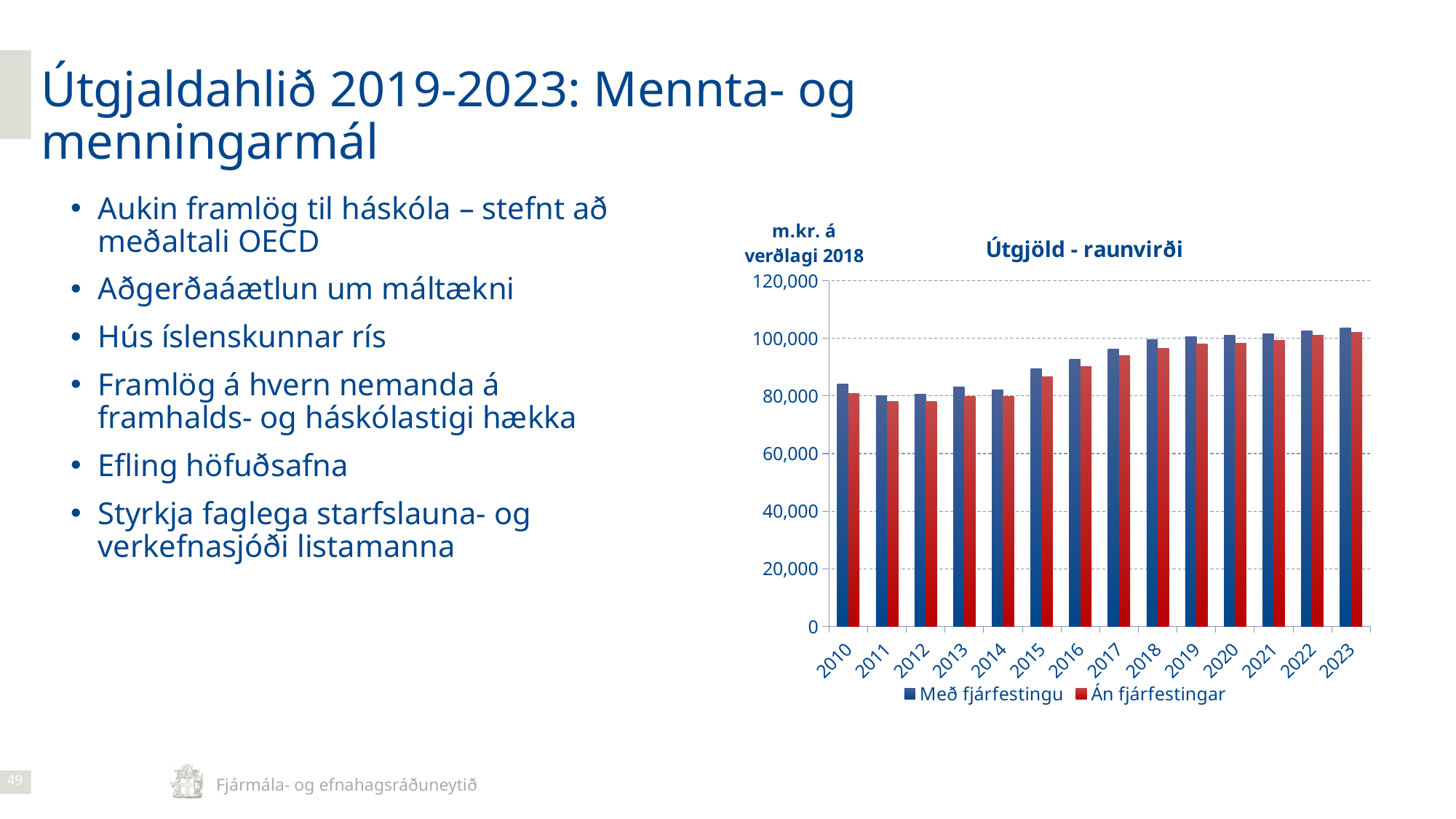
Do the values for Með fjárfestingu generally rise or fall from 2012 to 2023? rise How many series does the legend of the chart list? 2 How many years are shown on the x axis of the chart? 14 What kind of chart is shown on the slide? bar chart Which is larger, the value for Með fjárfestingu in 2010 or in 2011? 2010 Is the value for Með fjárfestingu in 2010 greater or less than 80,000? greater In which year is the value for Með fjárfestingu highest? 2023 Is the value for Án fjárfestingar in 2011 greater or less than 80,000? less Is the value for Án fjárfestingar in 2017 greater or less than 100,000? less What is the title of the chart? Útgjöld - raunvirði Which series is shown in red in the chart? Án fjárfestingar